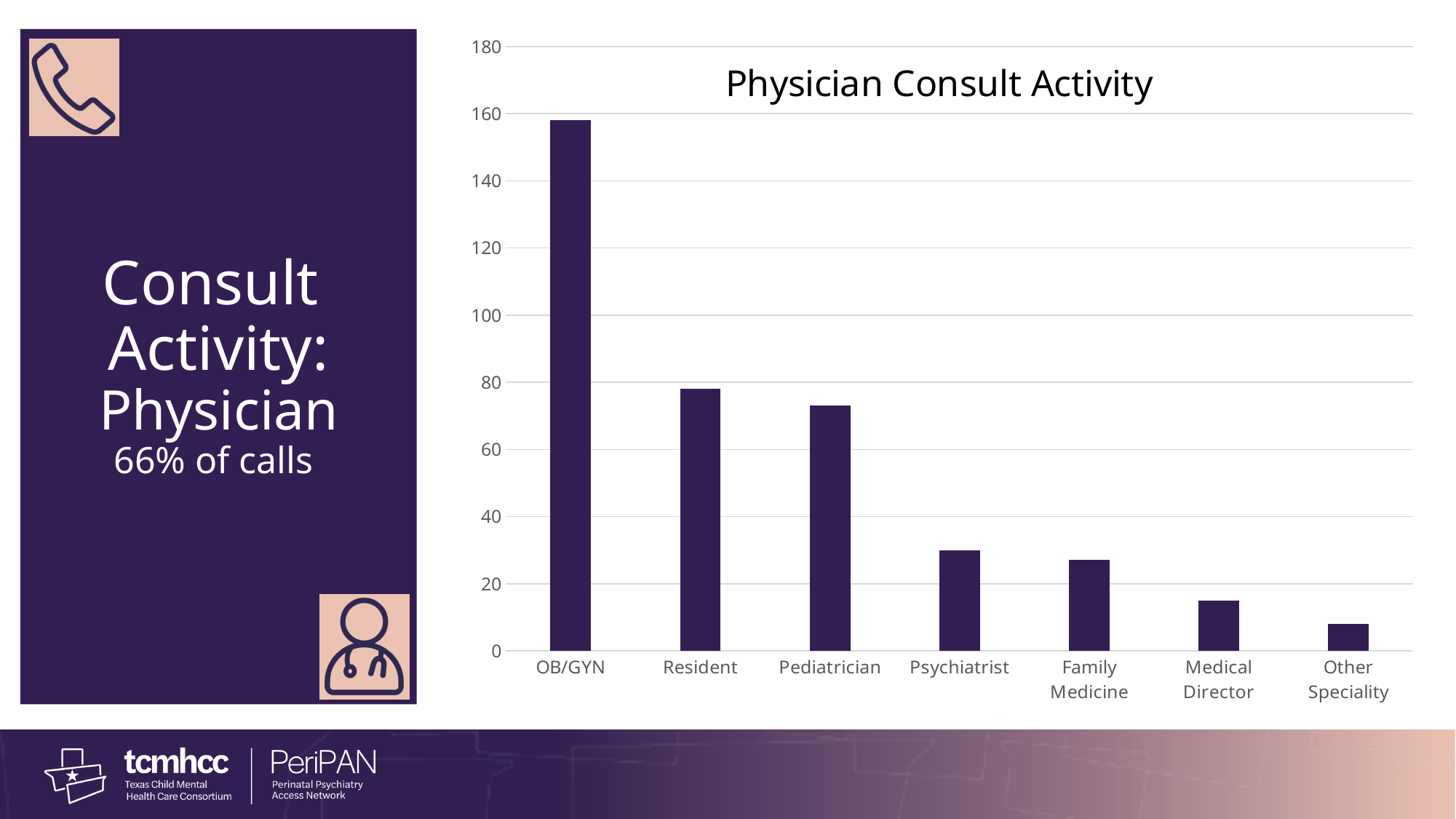
Is the value for Family Medicine greater or less than 40? less What type of chart is shown on the slide? bar chart Which category has the highest value in the chart? OB/GYN Which category has the lowest value in the chart? Other Speciality Do the values rise or fall moving from left to right along the x axis? fall Is the value for Pediatrician greater or less than 80? less Which has a larger value, OB/GYN or Resident? OB/GYN Is the value for Resident greater or less than 60? greater How many categories are shown on the x axis of the chart? 7 What is the title of the chart? Physician Consult Activity